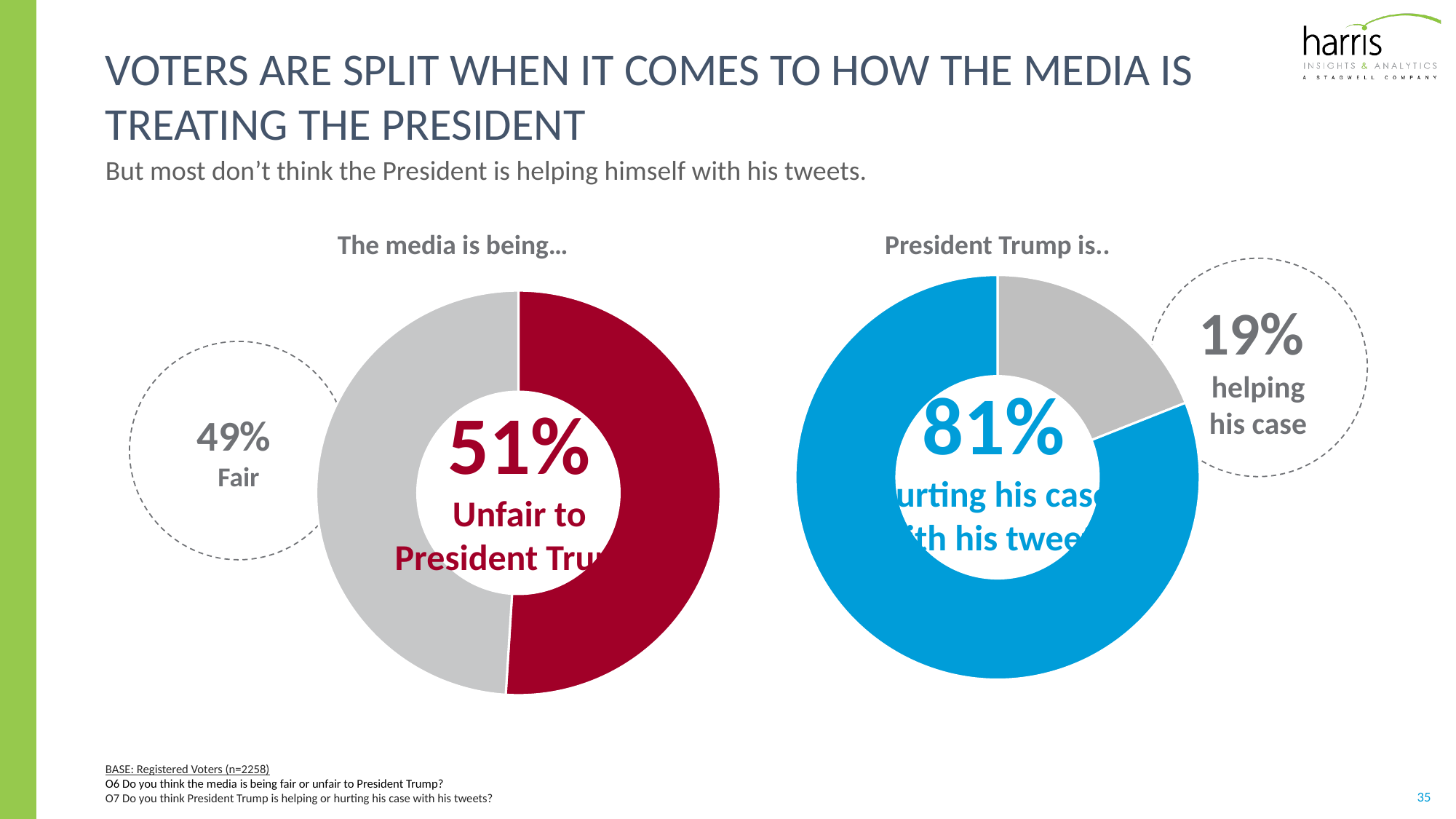
How many segments does the chart titled "President Trump is.." have? 2 In the chart titled "The media is being...", which response has the smaller share? Fair In the chart titled "President Trump is..", which is larger: the share saying he is hurting his case or the share saying he is helping his case? Hurting his case In the chart titled "The media is being...", what percentage of voters say the media is being unfair to President Trump? 51% In the chart titled "President Trump is..", which response has the largest share? Hurting his case with his tweets In the chart titled "The media is being...", what is the difference in percentage points between "Unfair to President Trump" and "Fair"? 2 percentage points In the chart titled "President Trump is..", what percentage say he is hurting his case with his tweets? 81% In the chart titled "President Trump is..", what is the difference in percentage points between "hurting his case" and "helping his case"? 62 percentage points In the chart titled "President Trump is..", what percentage say he is helping his case? 19% In the chart titled "The media is being...", what colour is the "Unfair to President Trump" segment? Red What kind of chart is used for "The media is being..."? Donut (pie) chart In the chart titled "The media is being...", what percentage of voters say the media is being fair? 49%